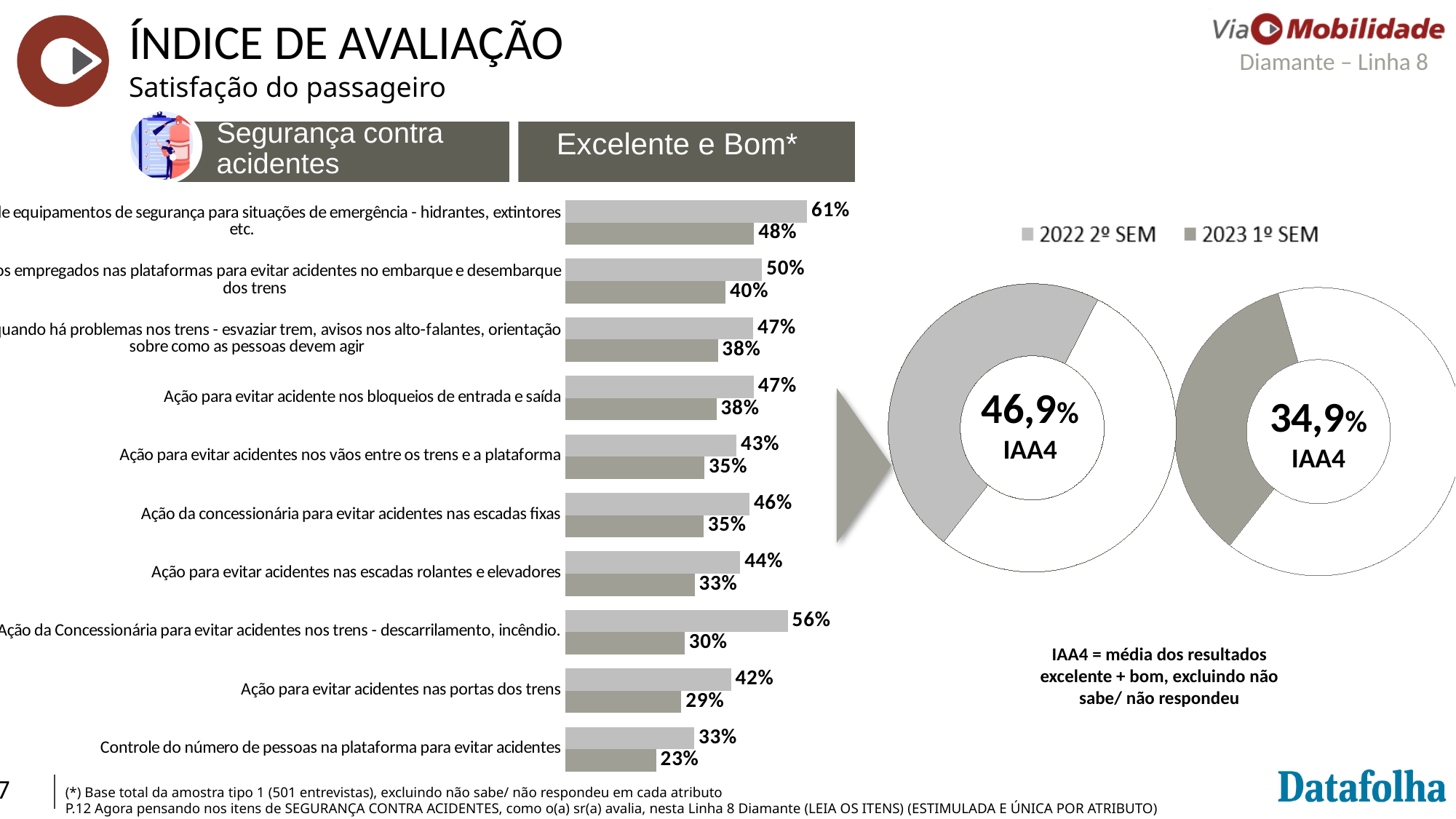
In the bar chart, what is the highest value shown for the 2022 2º SEM series? 61% What kind of chart is used to show the 'Excelente e Bom*' results by attribute? Bar chart How many categories does the bar chart show? 10 In the bar chart, what is the difference between the 2022 2º SEM and 2023 1º SEM values for 'Ação da Concessionária para evitar acidentes nos trens - descarrilamento, incêndio.'? 26% In the bar chart, what is the 2023 1º SEM value for 'Controle do número de pessoas na plataforma para evitar acidentes'? 23% In the bar chart, what is the 2023 1º SEM value for 'Ação da Concessionária para evitar acidentes nos trens - descarrilamento, incêndio.'? 30% In the left donut chart, what is the IAA4 value shown? 46,9% In the bar chart, which category has the lowest 2023 1º SEM value? Controle do número de pessoas na plataforma para evitar acidentes In the bar chart, which is larger for 'Ação para evitar acidentes nas escadas rolantes e elevadores': the 2022 2º SEM value or the 2023 1º SEM value? 2022 2º SEM How many series does the legend of the bar chart list? 2 In the bar chart, what is the 2022 2º SEM value for 'Ação para evitar acidentes nas portas dos trens'? 42% What is the difference between the IAA4 values in the left and right donut charts? 12,0%